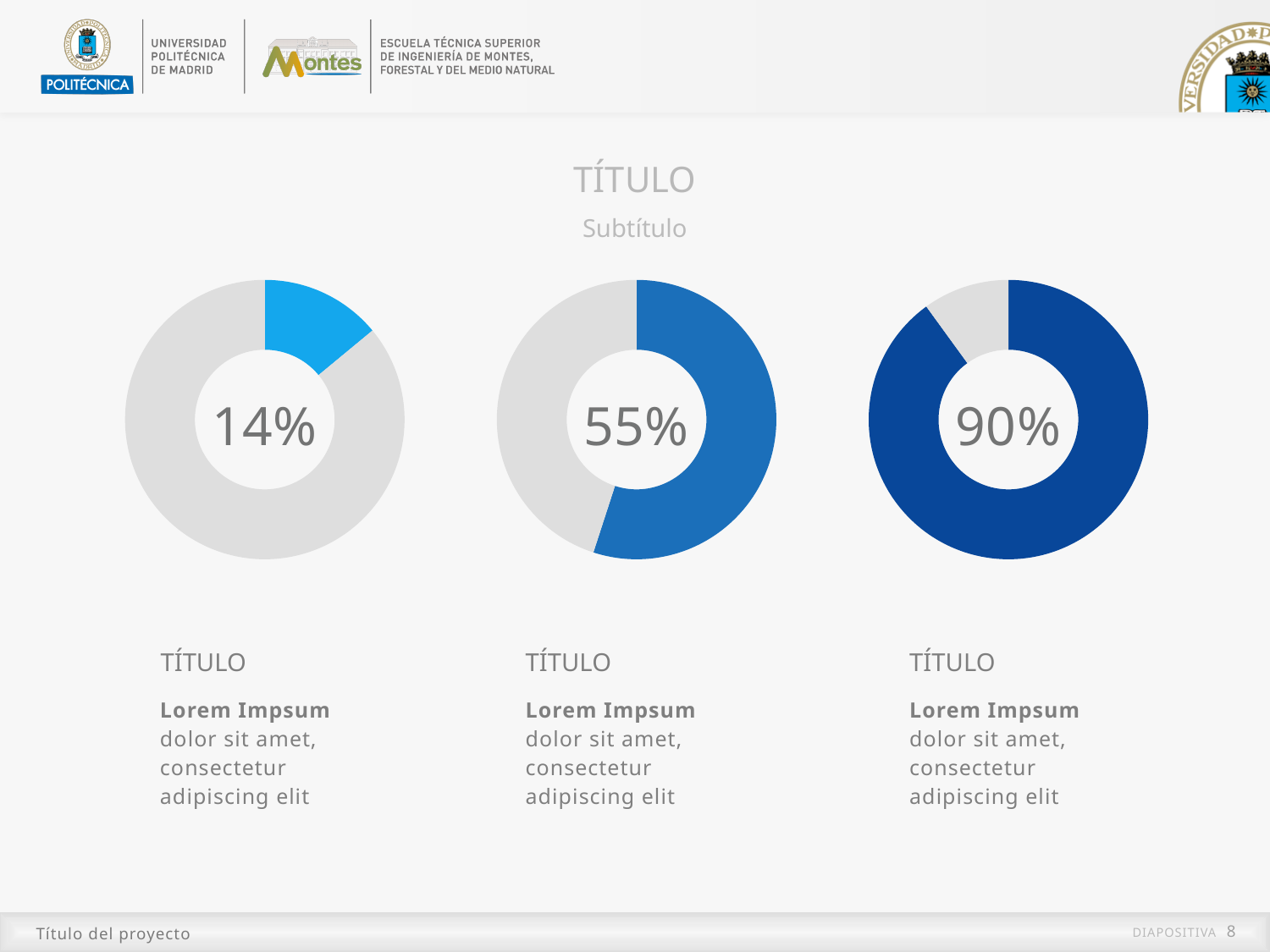
What is the difference between the percentage in the right donut chart and the percentage in the left donut chart? 76% What colour is the filled portion of the left donut chart? Light blue Which of the three donut charts shows the highest percentage? The right chart (90%) Which of the three donut charts shows the lowest percentage? The left chart (14%) What percentage is shown in the centre of the middle donut chart? 55% What percentage is shown in the centre of the left donut chart? 14% What is the difference between the percentage in the middle donut chart and the percentage in the left donut chart? 41% Do the percentages in the donut charts increase or decrease from left to right across the slide? Increase How many donut charts are shown on the slide? 3 Which is larger, the percentage in the middle donut chart or the percentage in the right donut chart? The right chart (90%) What kind of chart is used to display the three percentages on the slide? Donut chart What percentage is shown in the centre of the right donut chart? 90%